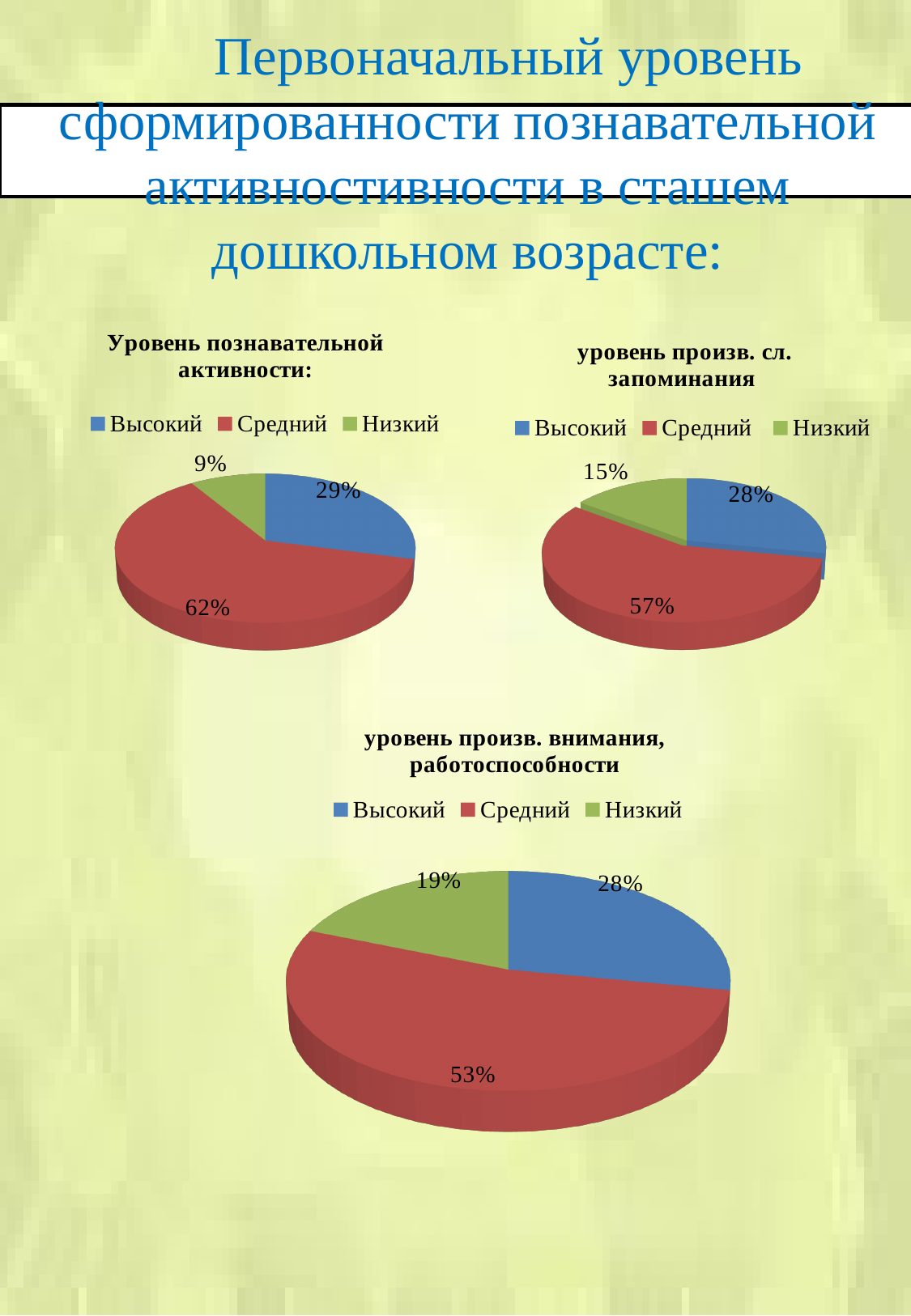
How many slices does the chart titled "уровень произв. внимания, работоспособности" have? 3 In the chart titled "уровень произв. сл. запоминания", what is the difference between "Средний" and "Высокий"? 29% In the chart titled "уровень произв. внимания, работоспособности", what is the difference between "Высокий" and "Низкий"? 9% In the chart titled "Уровень познавательной активности:", what share does "Средний" have? 62% In the chart titled "Уровень познавательной активности:", which category has the smallest slice? Низкий In the chart titled "Уровень познавательной активности:", what colour is the "Средний" slice? Red In the chart titled "уровень произв. внимания, работоспособности", what is the value for "Средний"? 53% How many categories does the legend of the chart titled "уровень произв. сл. запоминания" list? 3 In the chart titled "уровень произв. сл. запоминания", what is the value for "Низкий"? 15% In the chart titled "уровень произв. внимания, работоспособности", which is larger, "Высокий" or "Низкий"? Высокий In the chart titled "уровень произв. сл. запоминания", which category has the largest slice? Средний What type of chart is the one titled "Уровень познавательной активности:"? Pie chart